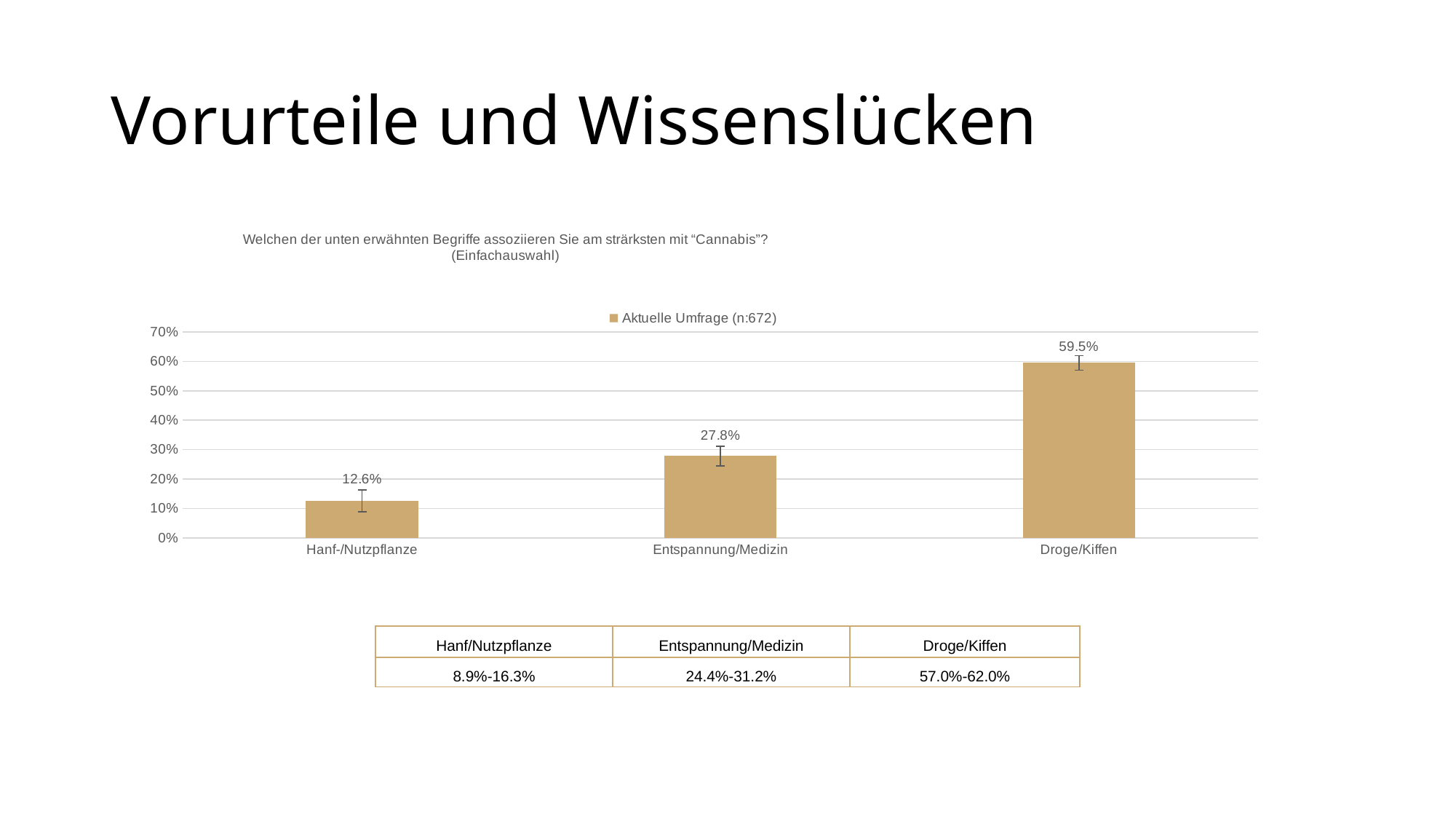
What is the value for Entspannung/Medizin? 27.8% What series does the legend list? Aktuelle Umfrage (n:672) Which is larger, the value for Entspannung/Medizin or the value for Hanf-/Nutzpflanze? Entspannung/Medizin Is the value for Droge/Kiffen greater or less than 50%? greater Which category has the highest value? Droge/Kiffen What is the difference between the values for Droge/Kiffen and Entspannung/Medizin? 31.7% How many categories are shown on the x axis? 3 What kind of chart is shown on the slide? bar chart What is the difference between the values for Entspannung/Medizin and Hanf-/Nutzpflanze? 15.2% Which category has the lowest value? Hanf-/Nutzpflanze What is the value for Hanf-/Nutzpflanze? 12.6% What is the value for Droge/Kiffen? 59.5%